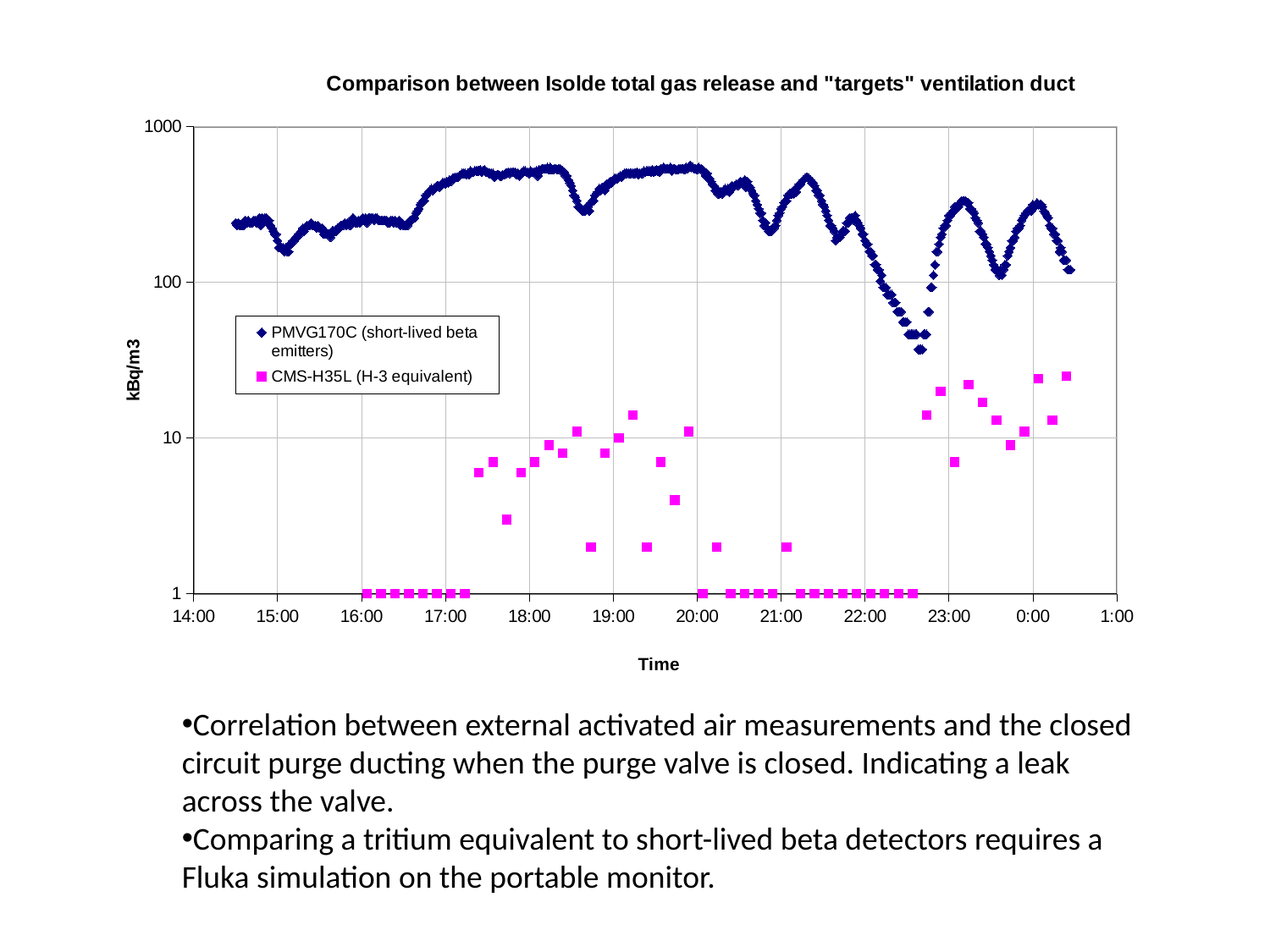
What kind of chart is shown on the slide? Scatter chart How many series does the chart legend list? 2 What is the label of the y axis? kBq/m3 Is the value for PMVG170C (short-lived beta emitters) at 18:00 greater or less than 100? greater Which series has the higher values at 18:00, PMVG170C (short-lived beta emitters) or CMS-H35L (H-3 equivalent)? PMVG170C (short-lived beta emitters) Is the value for PMVG170C (short-lived beta emitters) at 15:00 greater or less than 100? greater Is the value for CMS-H35L (H-3 equivalent) at 19:00 greater or less than 100? less Do the PMVG170C (short-lived beta emitters) values rise or fall between 22:00 and 22:30? fall What value do the CMS-H35L (H-3 equivalent) points between 16:00 and 17:00 sit on? 1 What is the title of the chart? Comparison between Isolde total gas release and "targets" ventilation duct